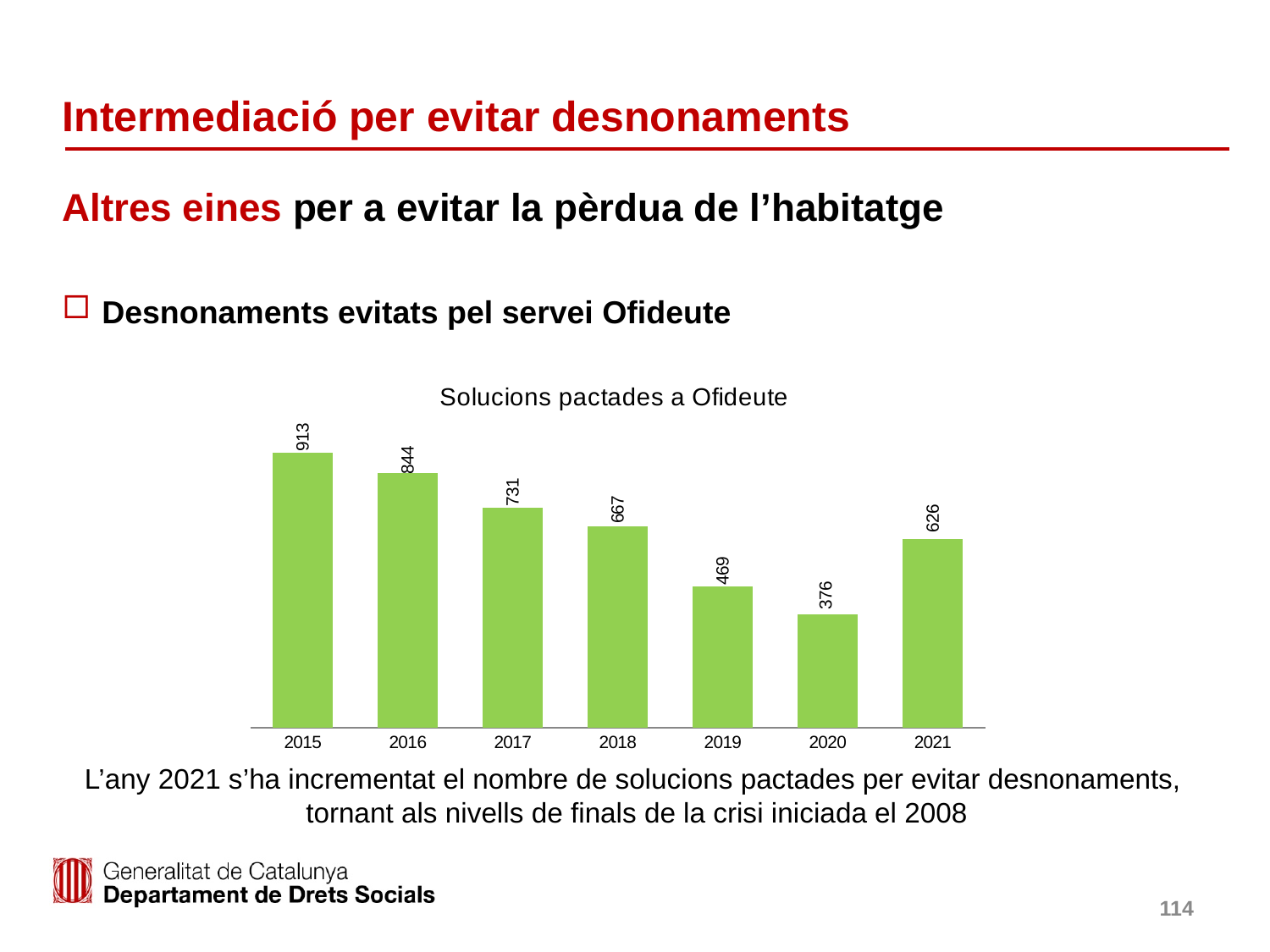
What is the title of the chart? Solucions pactades a Ofideute Which year has the lowest value in the chart? 2020 Do the values rise or fall from 2015 to 2020? Fall How many years are shown in the chart? 7 What is the value for 2021 in the chart? 626 What kind of chart is shown on the slide? Bar chart What is the difference between the values for 2015 and 2016? 69 Which year has the highest value in the chart? 2015 What is the difference between the values for 2021 and 2020? 250 Which is larger, the value for 2017 or the value for 2018? 2017 What is the value for 2020 in the chart? 376 What is the value for 2015 in the chart? 913